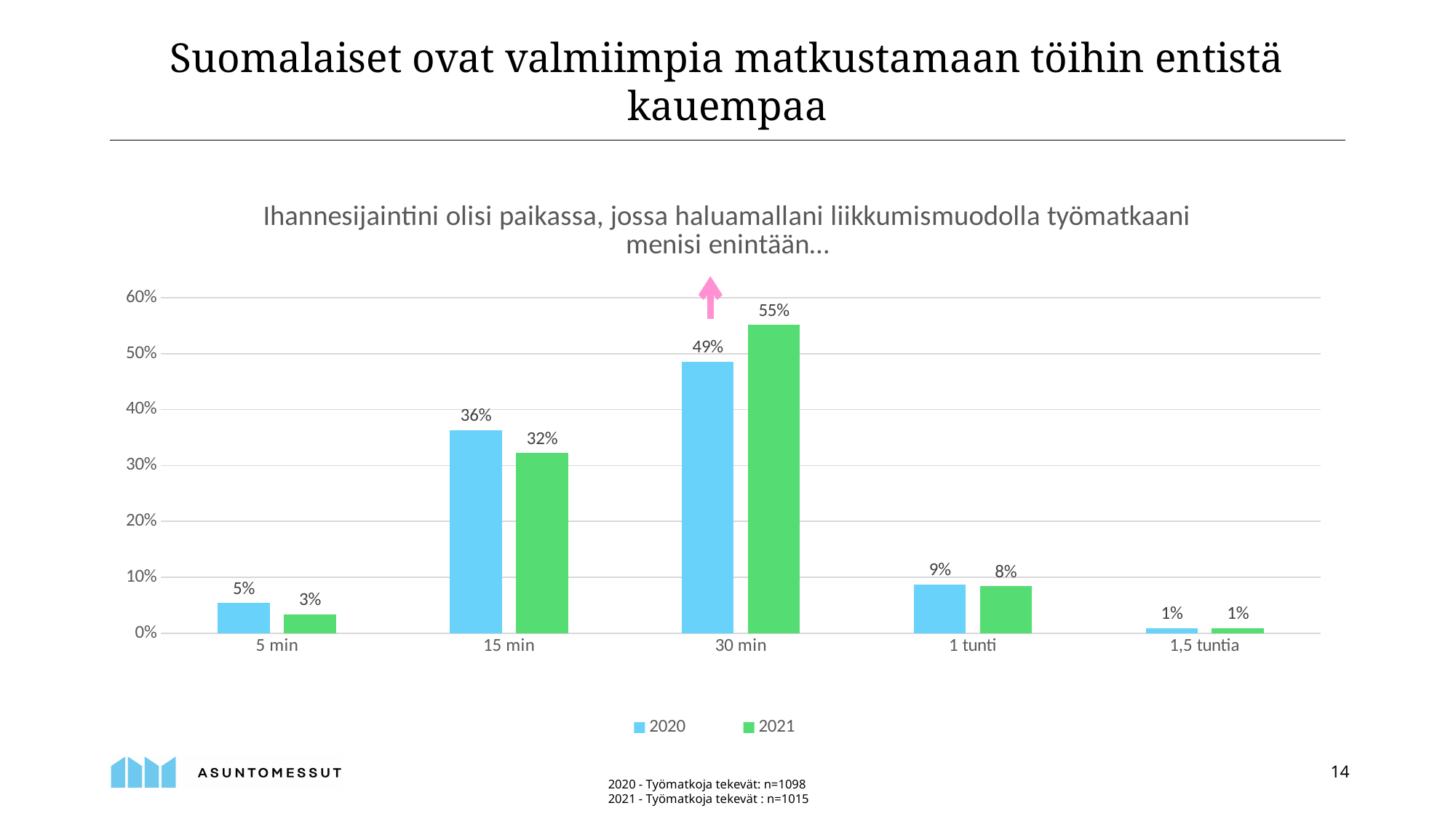
What is the difference between the 2021 and 2020 values for 30 min? 6% What is the difference between the 2020 and 2021 values for 15 min? 4% How many categories are shown on the x axis? 5 What is the value for 15 min in the 2020 series? 36% What is the value for 30 min in the 2021 series? 55% Is the 2021 value for 30 min greater or less than 50%? greater How many series does the legend list? 2 What kind of chart is shown on the slide? bar chart Which category has the highest value in the 2020 series? 30 min What is the value for 5 min in the 2021 series? 3% Which category has the lowest value in the 2021 series? 1,5 tuntia Which is larger for 1 tunti: the 2020 value or the 2021 value? 2020